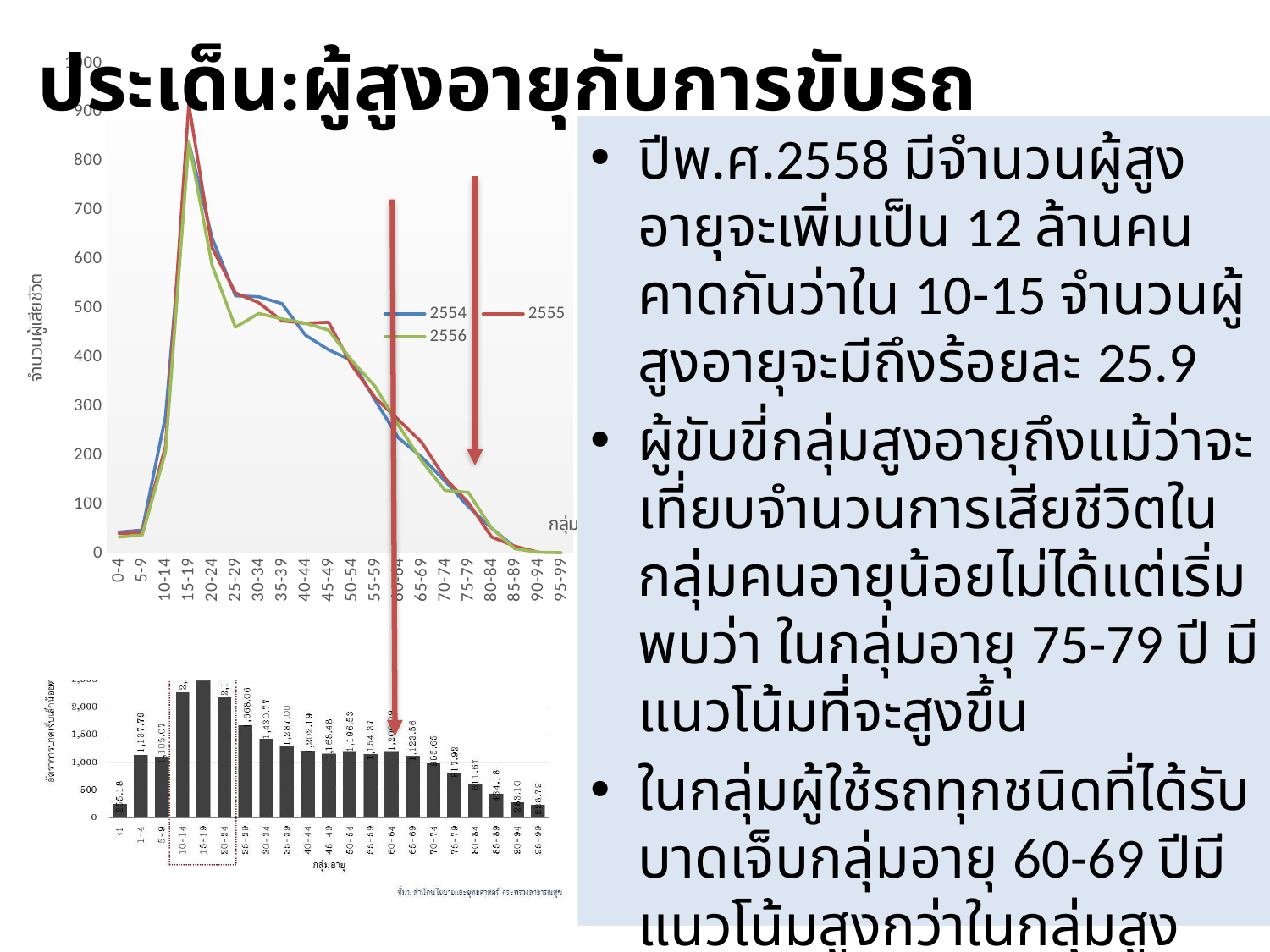
In the bottom bar chart, what is the difference between the values for age groups 70-74 and 75-79? 247.73 What kind of chart is the bottom chart on the slide? bar chart In the top line chart, is the value for the 2555 series at age group 15-19 greater or less than 800? greater In the bottom bar chart, which is larger, the value for age group 25-29 or for age group 30-34? 25-29 In the bottom bar chart, which age group has the highest bar? 15-19 In the bottom bar chart, what is the value for age group 75-79? 717.92 What kind of chart is the top chart on the slide? line chart In the top line chart, how many series does the legend list? 3 In the top line chart, do the values rise or fall along the x axis from age group 15-19 to 95-99? fall In the top line chart, is the value for the 2554 series at age group 0-4 greater or less than 100? less In the bottom bar chart, what is the value for age group 30-34? 1,430.77 In the top line chart, which age group has the highest value for the 2555 series? 15-19